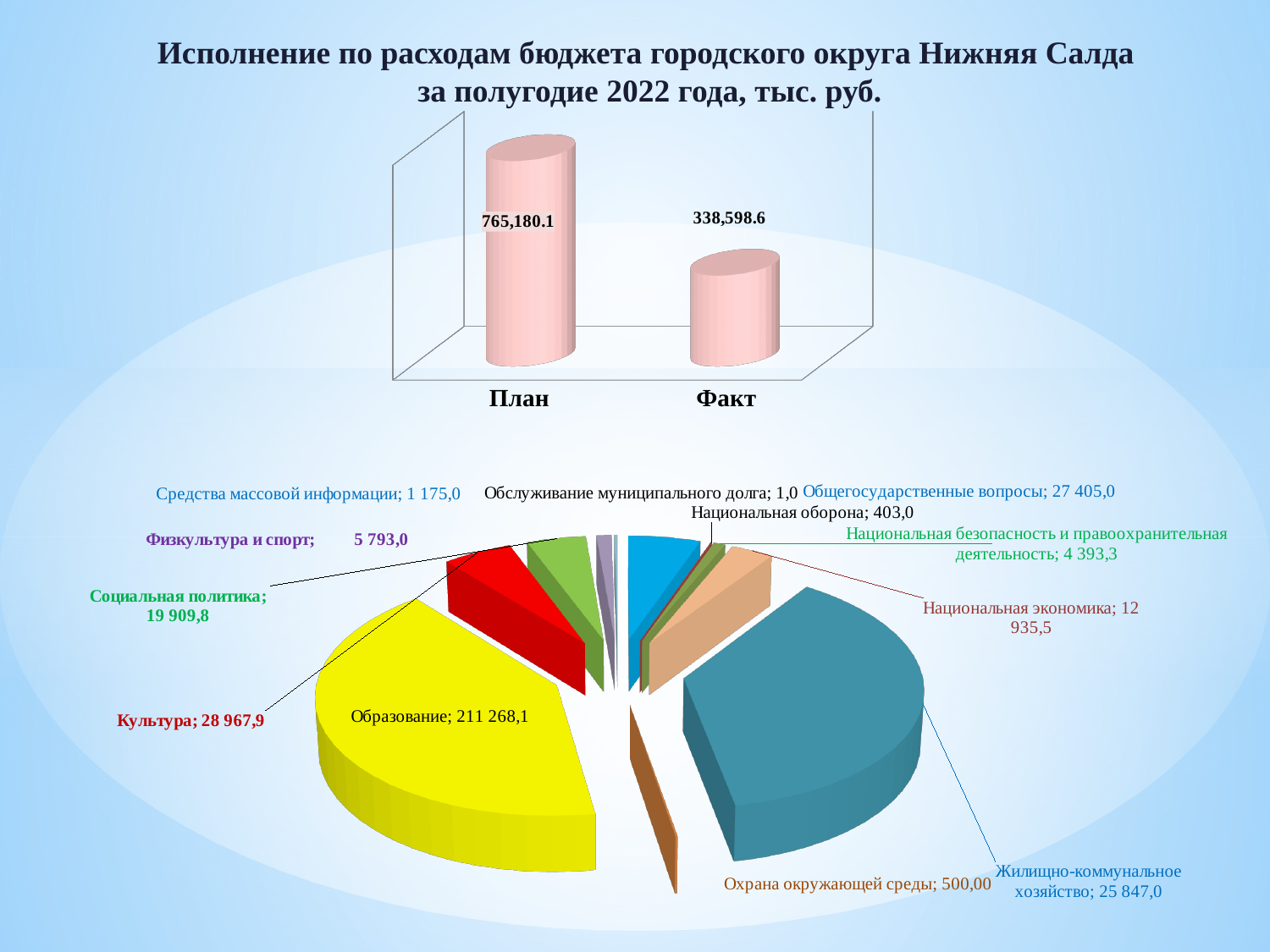
In the top bar chart, which is larger, План or Факт? План In the bottom pie chart, which category has the smallest value? Обслуживание муниципального долга In the bottom pie chart, what is the value for Образование? 211 268,1 What type of chart is the bottom chart on the slide? Pie chart In the top bar chart, what is the value for План? 765,180.1 In the bottom pie chart, what is the value for Жилищно-коммунальное хозяйство? 25 847,0 In the bottom pie chart, which category has the largest value? Образование In the top bar chart, what is the value for Факт? 338,598.6 How many slices does the bottom pie chart have? 12 In the bottom pie chart, what is the difference between Социальная политика and Национальная экономика? 6 974,3 In the top bar chart, what is the difference between План and Факт? 426,581.5 What type of chart is the top chart on the slide? Bar chart